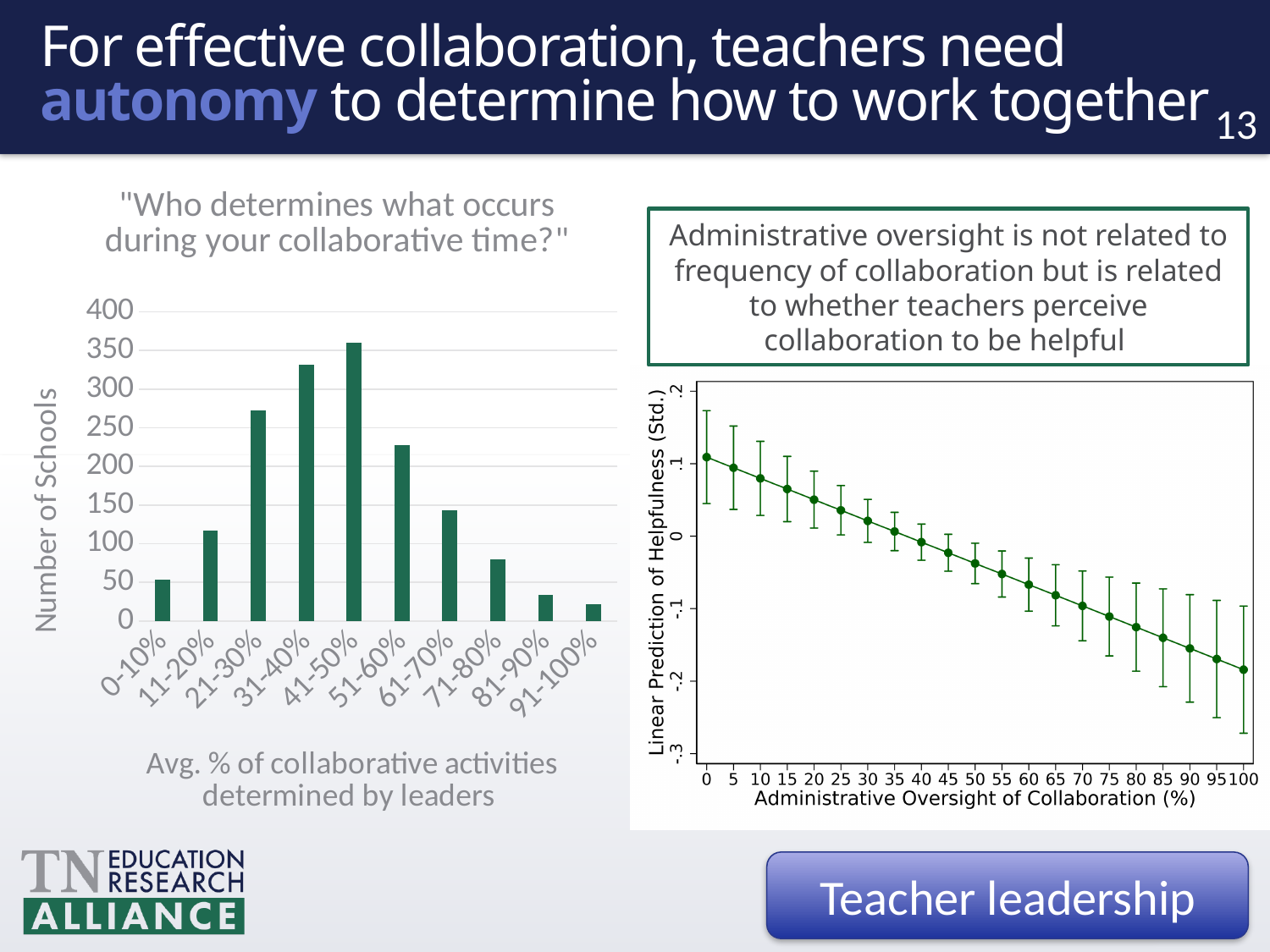
In the bar chart titled "Who determines what occurs during your collaborative time?", which category has the lowest number of schools? 91-100% In the bar chart on the left, which is larger: the value for 31-40% or the value for 51-60%? 31-40% What is the x-axis label of the chart on the right? Administrative Oversight of Collaboration (%) What kind of chart is the chart on the left of the slide? bar chart In the bar chart on the left, is the value for 0-10% greater or less than 100? less In the bar chart titled "Who determines what occurs during your collaborative time?", which category has the highest number of schools? 41-50% In the chart on the right, do the plotted values rise or fall as Administrative Oversight of Collaboration (%) increases? fall How many categories are shown on the x axis of the bar chart on the left? 10 What is the y-axis label of the bar chart on the left? Number of Schools In the bar chart on the left, is the value for 21-30% greater or less than 250? greater